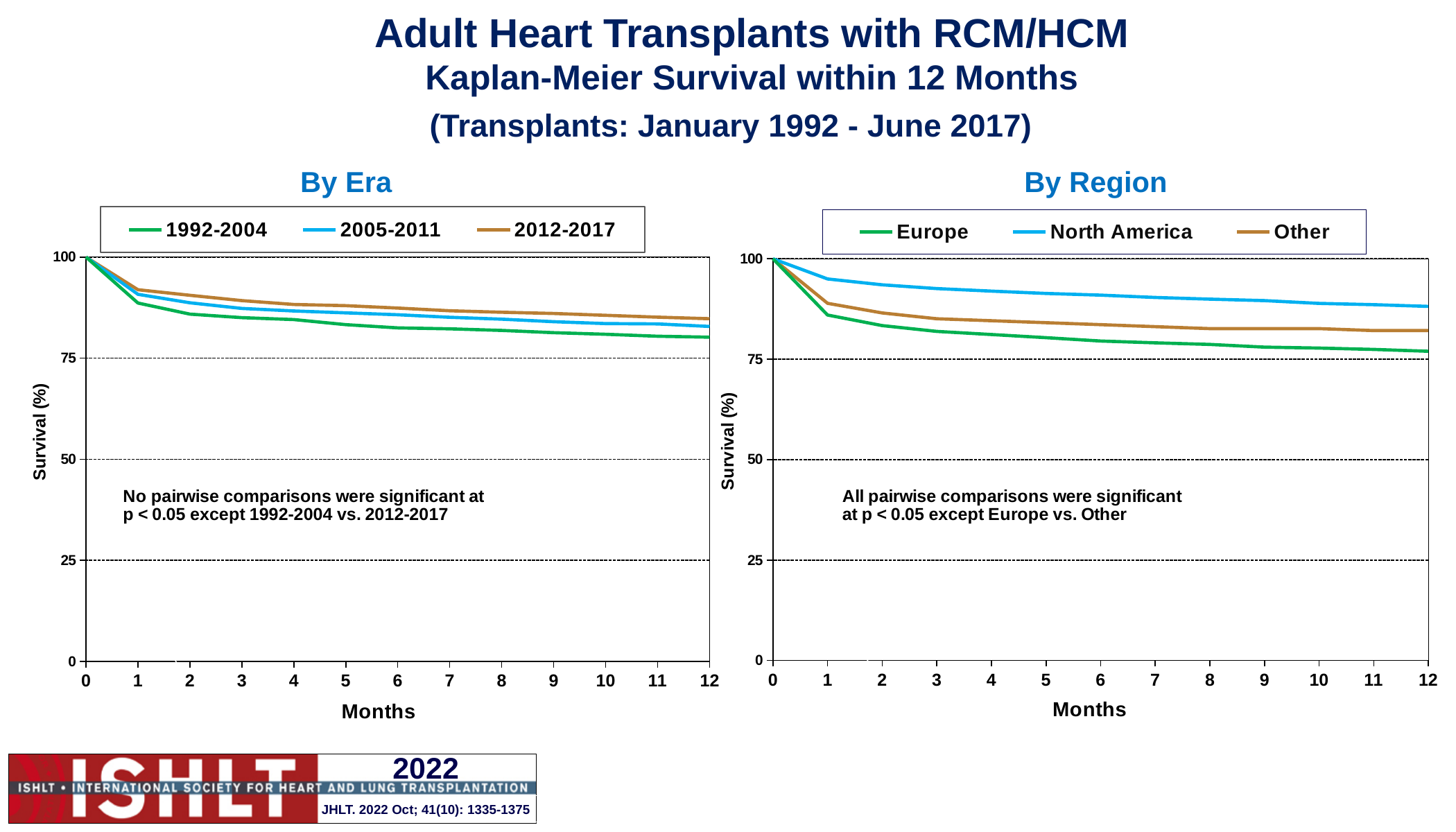
How many series does the legend of the 'By Region' chart list? 3 In the 'By Region' chart, which region has the lowest survival at 12 months? Europe In the 'By Region' chart, which is larger at month 6: the survival for North America or for Europe? North America In the 'By Era' chart, do the survival values rise or fall as months increase? fall In the 'By Era' chart, which era has the lowest survival at 12 months? 1992-2004 In the 'By Region' chart, is the survival for North America at 12 months greater or less than 75? greater In the 'By Era' chart, is the survival for 1992-2004 at 12 months greater or less than 75? greater In the 'By Region' chart, what is the survival value for North America at month 0? 100 What kind of chart is the 'By Era' chart? line chart What is the label of the x axis on the 'By Region' chart? Months In the 'By Era' chart, which series does the legend list first? 1992-2004 In the 'By Region' chart, which region has the highest survival at 12 months? North America